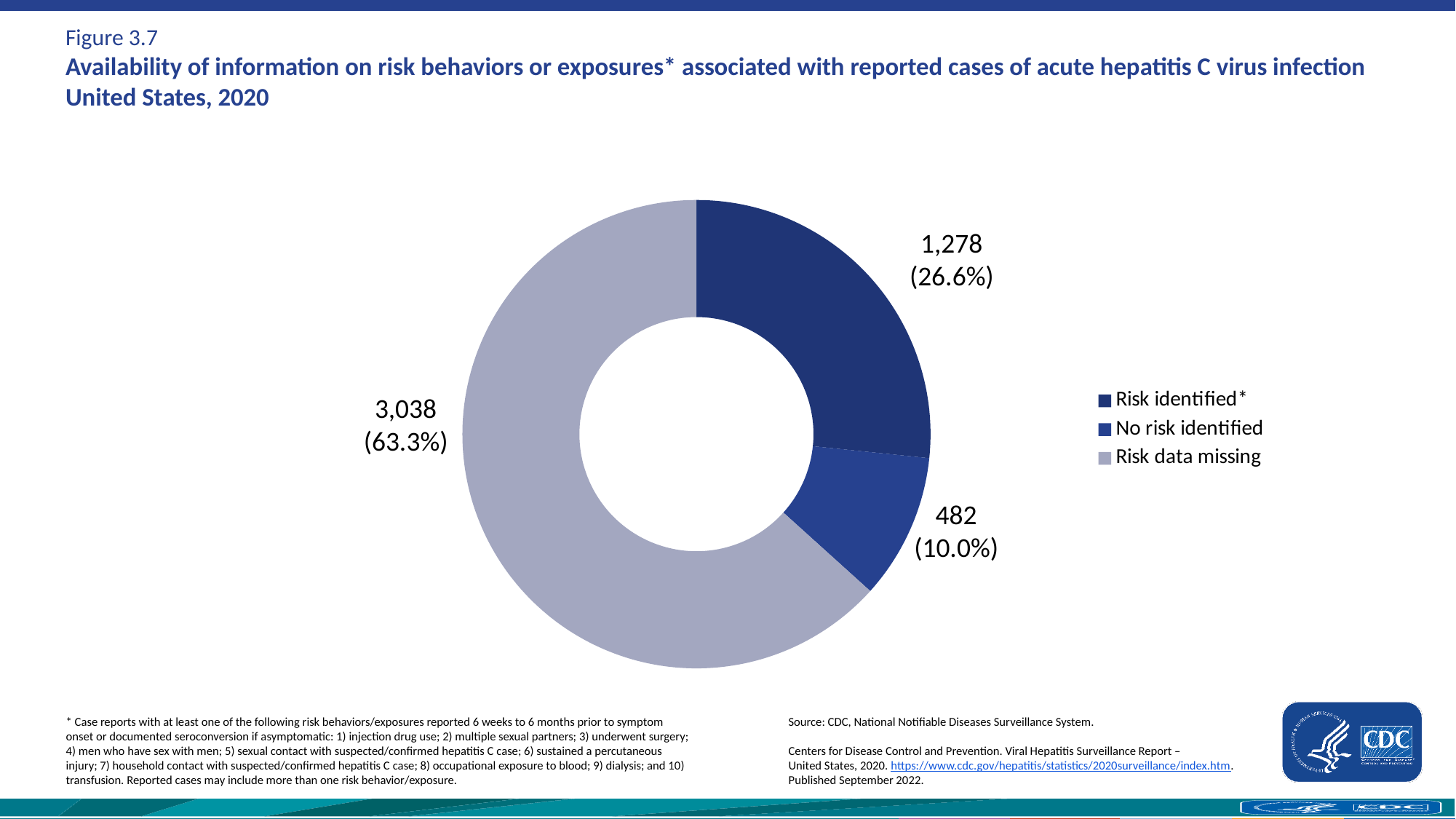
Which is larger: 'Risk identified' or 'No risk identified'? Risk identified How many cases are in the 'Risk data missing' category? 3,038 What share of the pie does 'Risk identified' represent? 26.6% Which category has the largest number of cases? Risk data missing What type of chart is shown on the slide? Pie chart (doughnut) How many cases are in the 'No risk identified' category? 482 Which category has the smallest number of cases? No risk identified What share of the pie does 'No risk identified' represent? 10.0% How many categories does the legend list? 3 What share of the pie does 'Risk data missing' represent? 63.3% How many cases are in the 'Risk identified' category? 1,278 What is the difference in cases between 'Risk data missing' and 'Risk identified'? 1,760